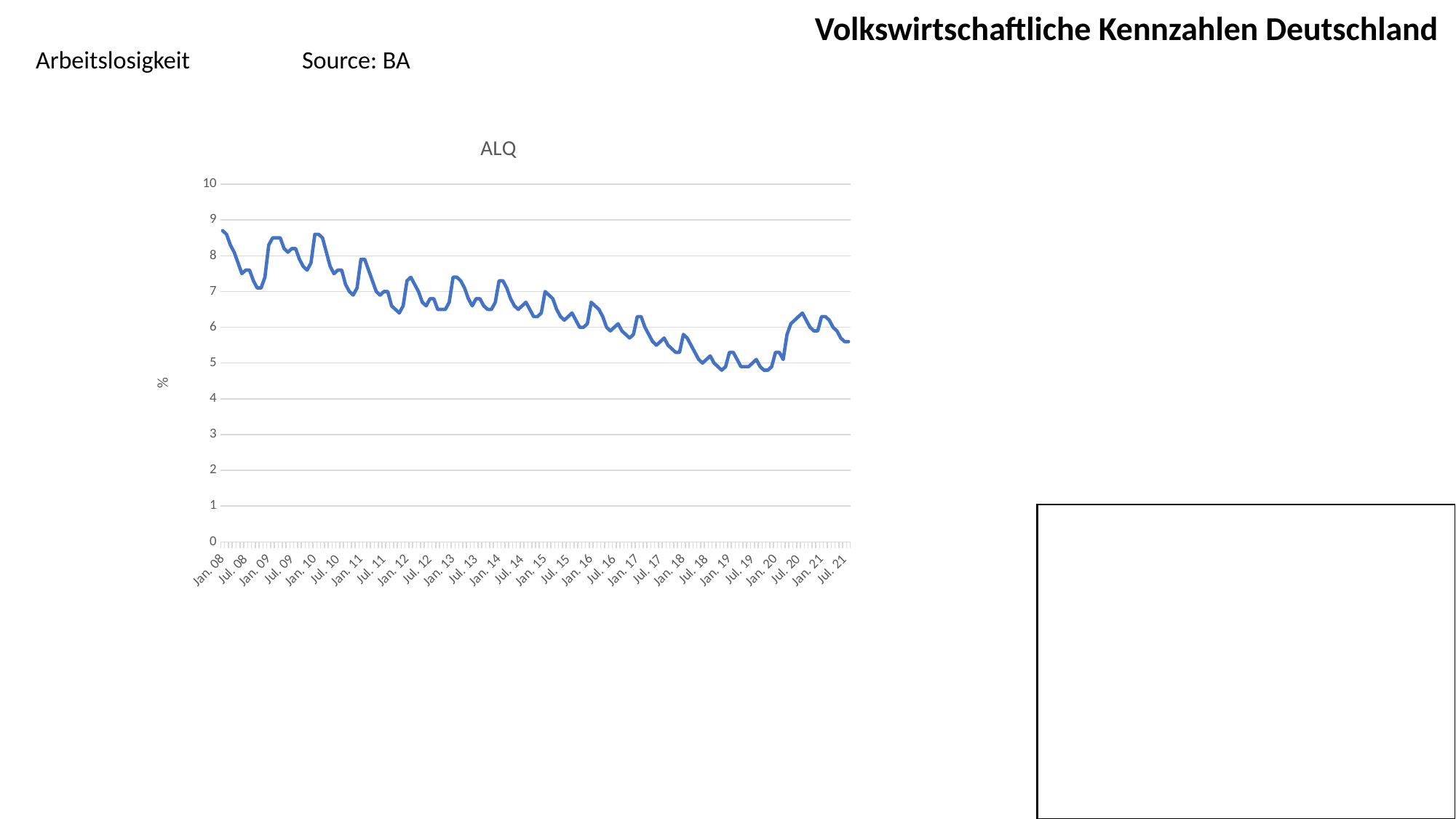
What kind of chart is shown on the slide? line chart Is the value for Jul. 21 greater or less than 5? greater Is the value for Jul. 21 greater or less than 6? less What is the title of the chart? ALQ Is the value for Jan. 15 greater or less than 6? greater What label is shown on the vertical axis of the chart? % Overall, does the ALQ line rise or fall from Jan. 08 to Jul. 21? fall